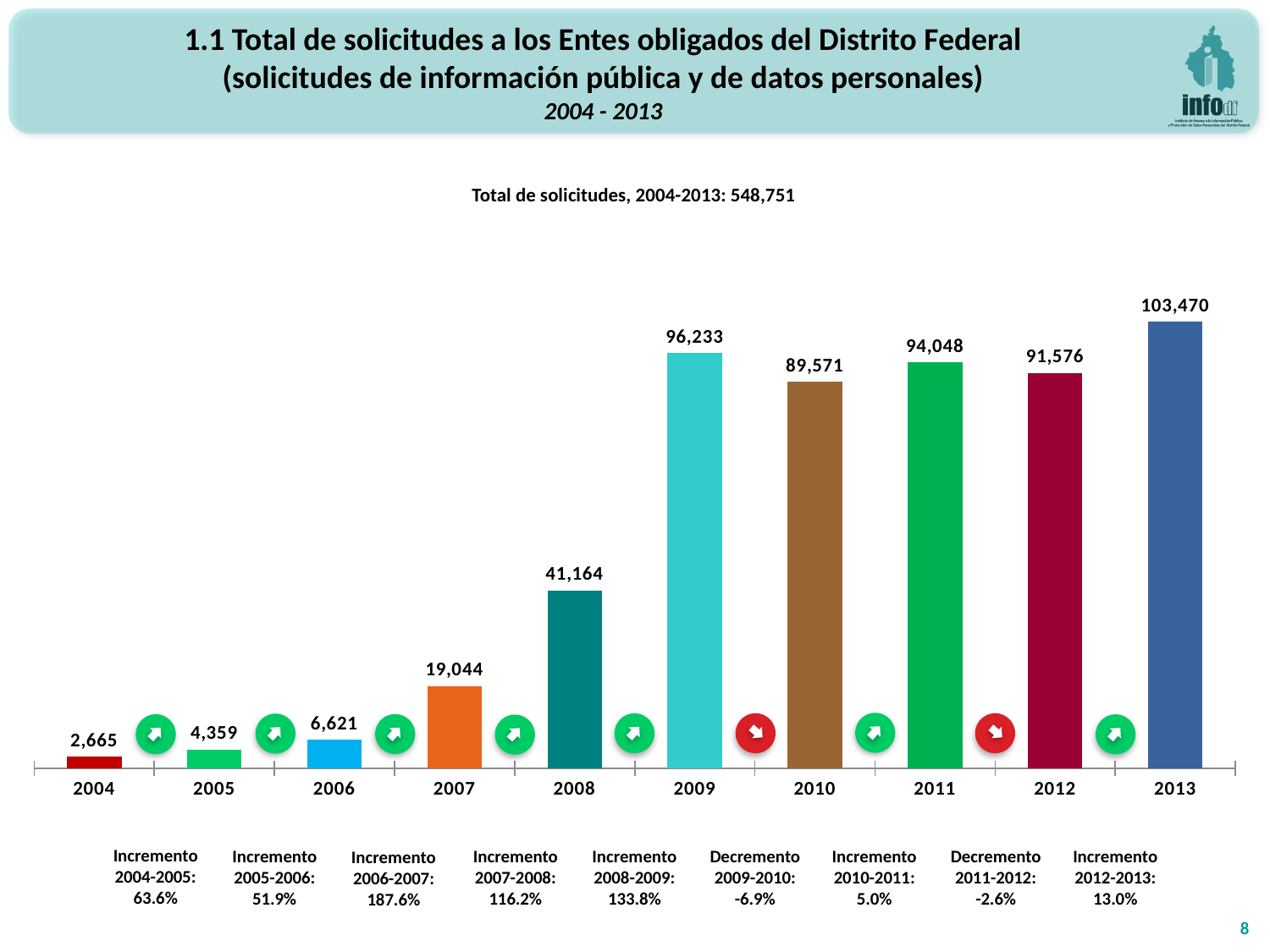
What kind of chart is shown on the slide? bar chart What is the difference between the values for 2013 and 2012? 11,894 Which is larger, the value for 2011 or the value for 2012? 2011 What total of solicitudes for 2004-2013 is stated above the chart? 548,751 What is the value for 2004? 2,665 Which is larger, the value for 2009 or the value for 2010? 2009 What is the value for 2013? 103,470 How many years are shown on the x axis? 10 Which year has the lowest value? 2004 What is the value for 2008? 41,164 Which year has the highest value? 2013 What is the difference between the values for 2009 and 2010? 6,662